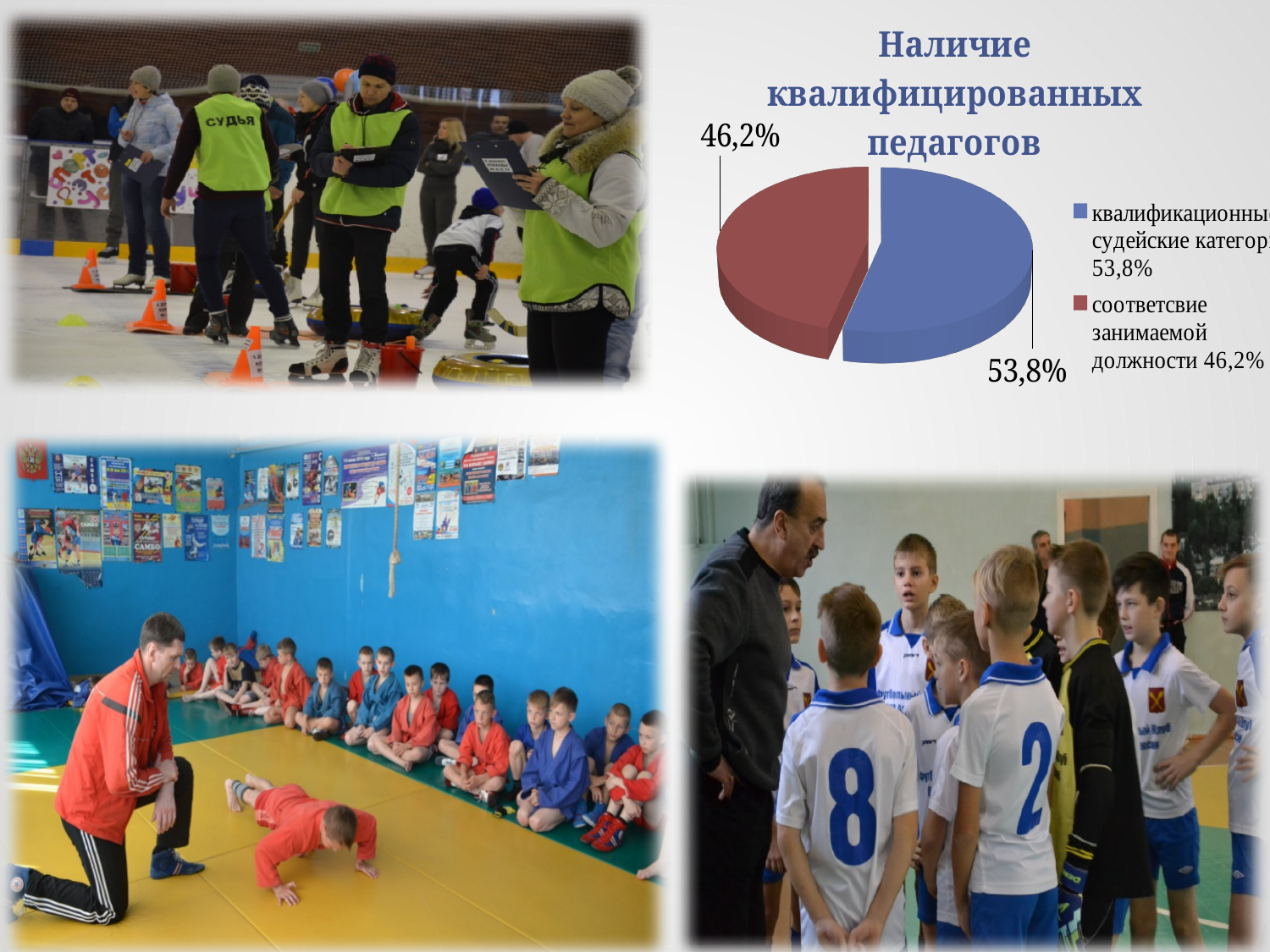
What is the title of the chart? Наличие квалифицированных педагогов What share of the pie is labelled for the red slice (соответсвие занимаемой должности)? 46,2% What kind of chart is shown on the slide? pie chart Which slice is the largest in the pie chart? квалификационные судейские категории (53,8%) What colour is the slice representing квалификационные судейские категории? blue How many slices does the pie chart have? 2 Which slice is the smallest in the pie chart? соответсвие занимаемой должности (46,2%) Is the share for соответсвие занимаемой должности greater or less than 50%? less How many entries does the legend list? 2 What is the difference in percentage points between the two slices of the pie chart? 7,6 Which is larger: the slice for квалификационные судейские категории or the slice for соответсвие занимаемой должности? квалификационные судейские категории What share of the pie is labelled for the blue slice (квалификационные судейские категории)? 53,8%